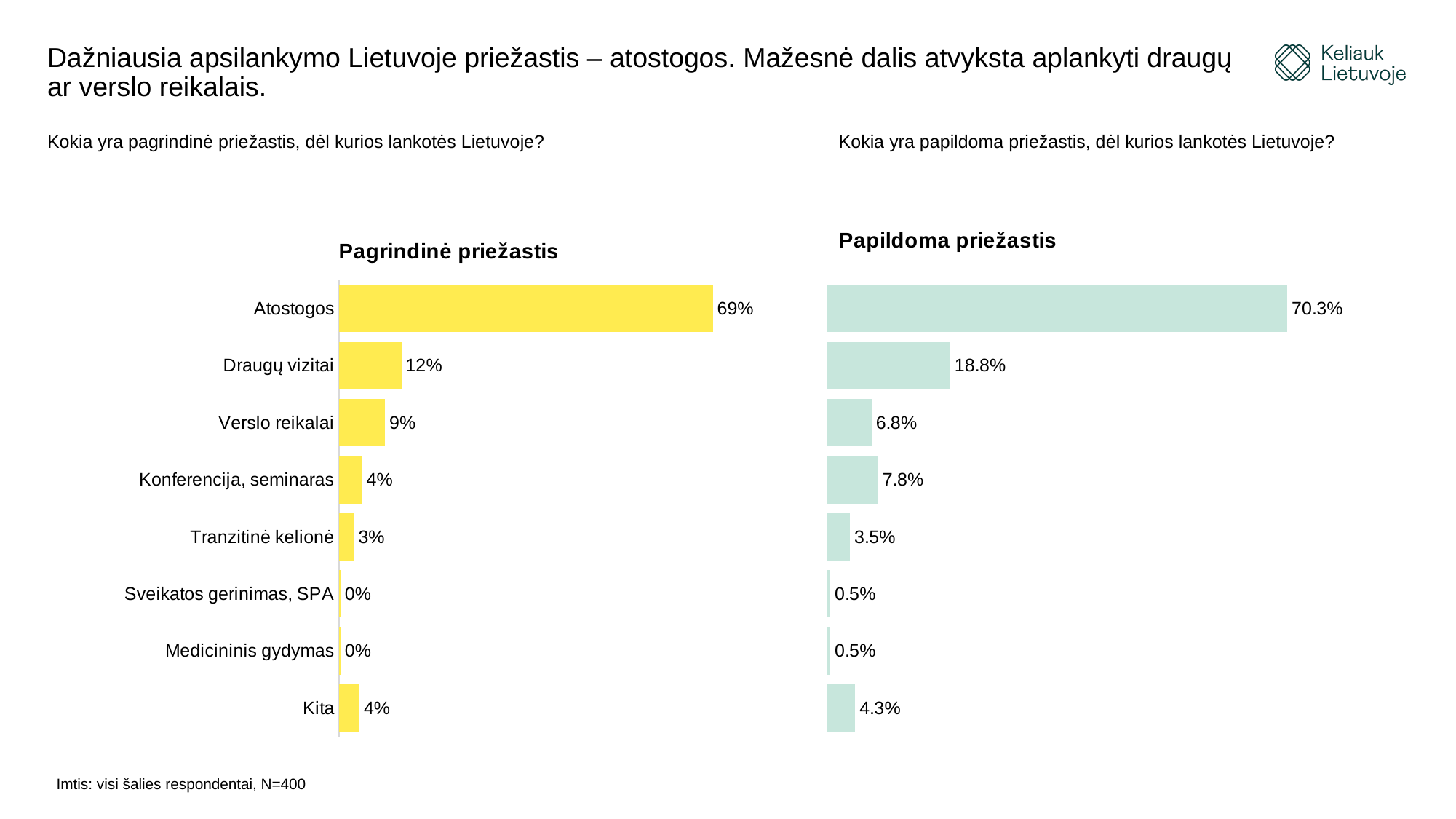
How many categories does the 'Pagrindinė priežastis' chart show? 8 In the 'Papildoma priežastis' chart, what is the value for Draugų vizitai? 18.8% In the 'Papildoma priežastis' chart, what is the difference between Atostogos and Draugų vizitai? 51.5% In the 'Pagrindinė priežastis' chart, what is the value for Atostogos? 69% What kind of chart is the 'Papildoma priežastis' chart? Bar chart In the 'Pagrindinė priežastis' chart, what is the value for Verslo reikalai? 9% In the 'Pagrindinė priežastis' chart, which category has the highest value? Atostogos In the 'Papildoma priežastis' chart, which category has the highest value? Atostogos In the 'Papildoma priežastis' chart, which is larger: Verslo reikalai or Konferencija, seminaras? Konferencija, seminaras What colour are the bars in the 'Pagrindinė priežastis' chart? Yellow In the 'Papildoma priežastis' chart, what is the value for Konferencija, seminaras? 7.8% In the 'Pagrindinė priežastis' chart, what is the difference between Draugų vizitai and Verslo reikalai? 3%